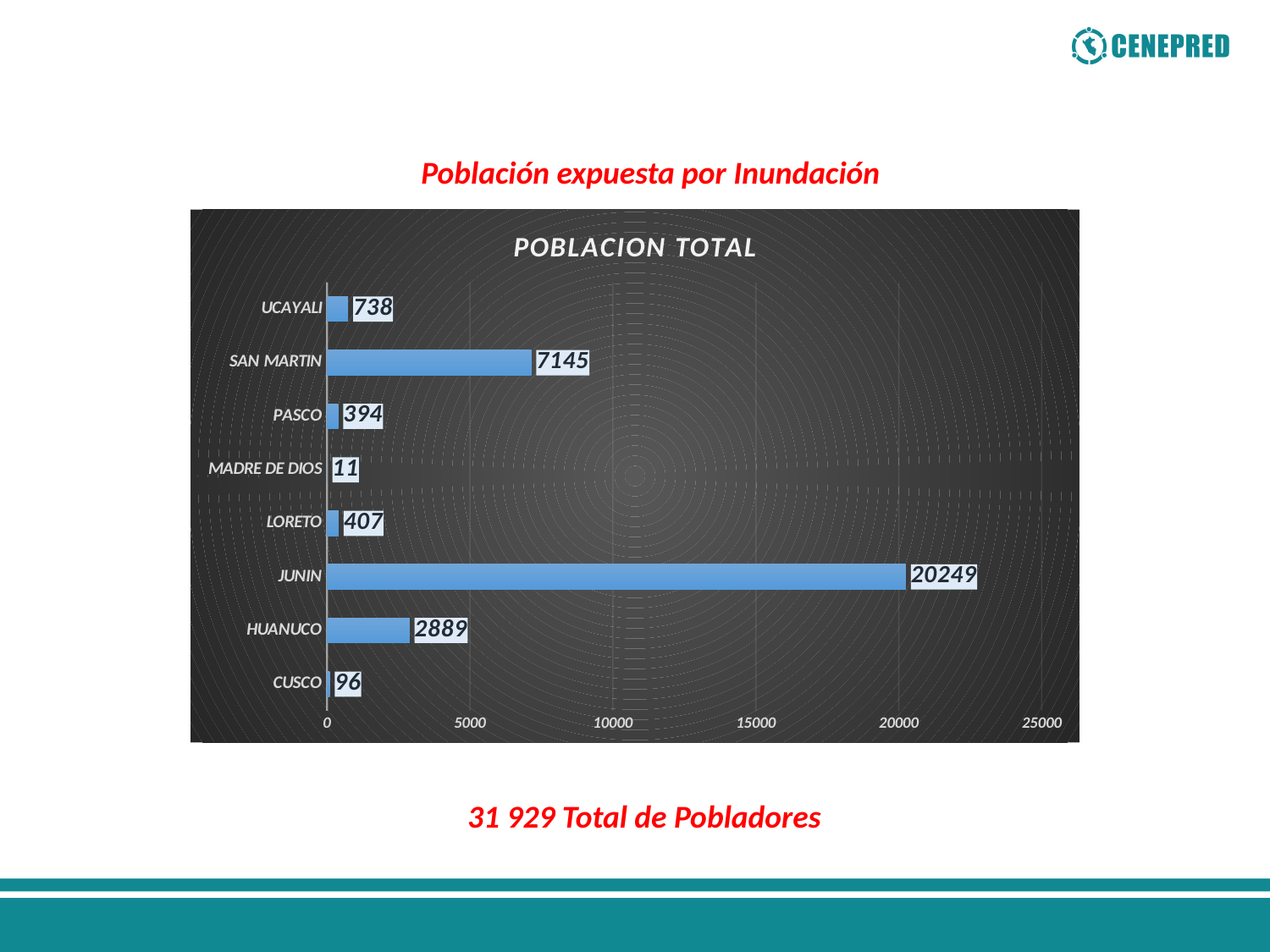
How many categories are shown on the chart? 8 Is the value for SAN MARTIN greater or less than 5000? greater Which is larger, the value for UCAYALI or the value for LORETO? UCAYALI What kind of chart is shown? bar chart Which category has the highest value? JUNIN What is the value for MADRE DE DIOS? 11 What is the value for JUNIN? 20249 What is the title of the chart? POBLACION TOTAL What is the value for HUANUCO? 2889 Which category has the lowest value? MADRE DE DIOS What is the value for SAN MARTIN? 7145 What is the difference between the values for JUNIN and SAN MARTIN? 13104